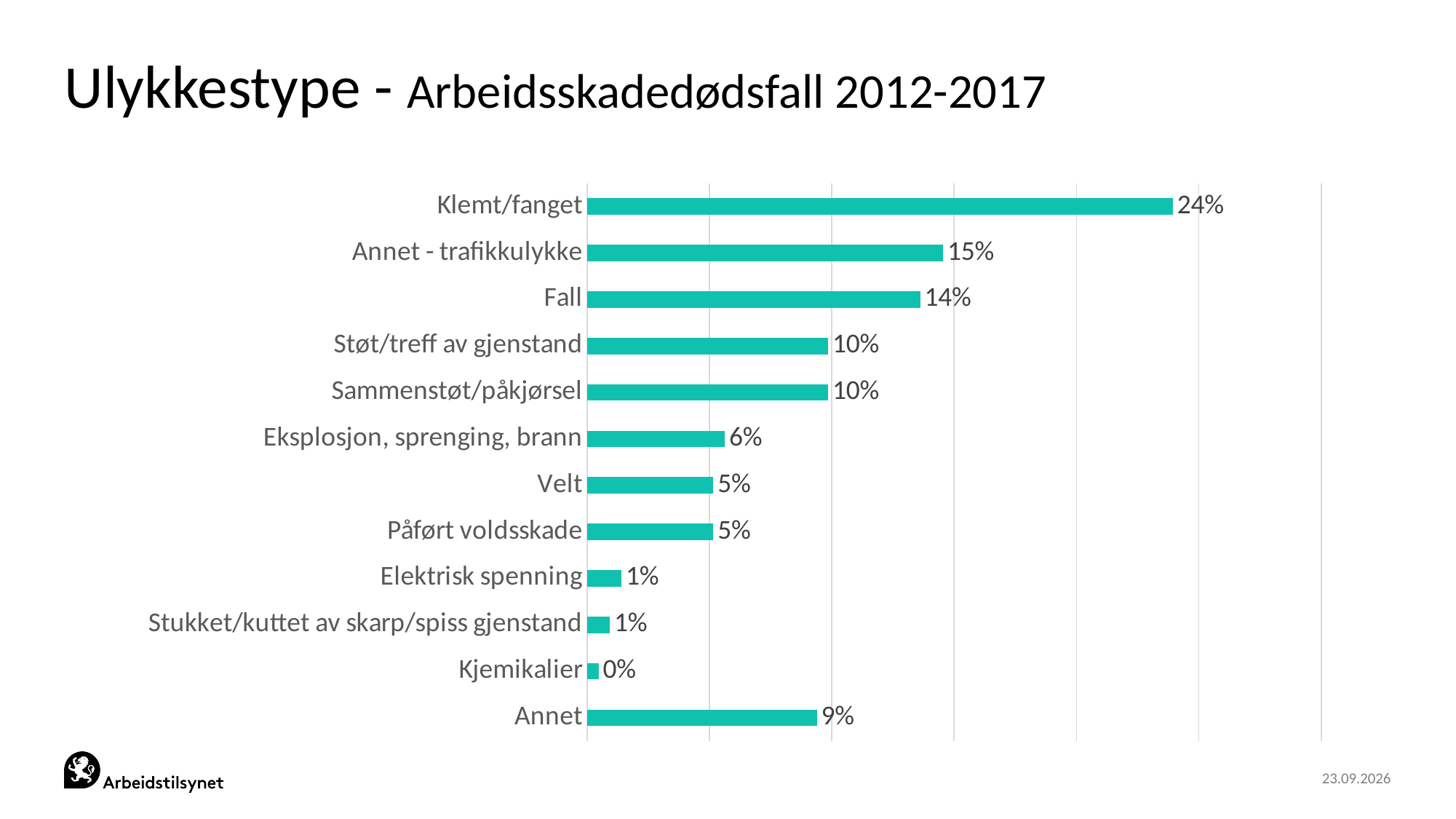
What is the value for Annet? 9% How many categories are shown in the chart? 12 What is the title of the slide? Ulykkestype - Arbeidsskadedødsfall 2012-2017 Which is larger, the value for Fall or the value for Annet? Fall Which category has the lowest value? Kjemikalier What kind of chart is shown on the slide? Bar chart What is the value for Fall? 14% What is the value for Klemt/fanget? 24% What is the value for Stukket/kuttet av skarp/spiss gjenstand? 1% Which category has the highest value? Klemt/fanget What is the difference between the values for Klemt/fanget and Annet - trafikkulykke? 9% What is the value for Eksplosjon, sprenging, brann? 6%